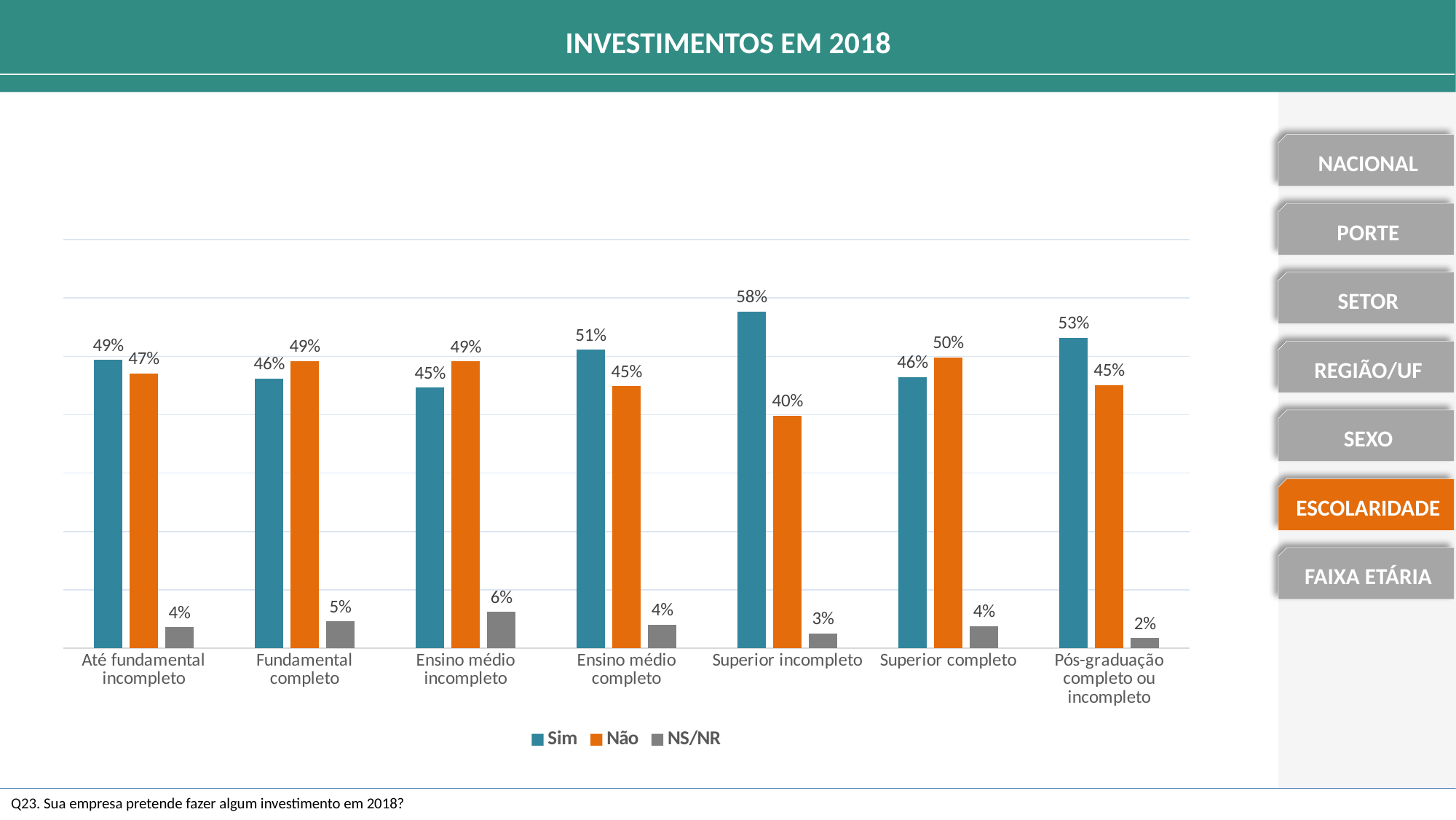
Which category has the highest "Sim" value? Superior incompleto Which series is shown in orange? Não What is the value of "Não" for Ensino médio completo? 45% What is the title of the slide? INVESTIMENTOS EM 2018 Which category has the lowest "NS/NR" value? Pós-graduação completo ou incompleto How many education categories are shown on the x axis? 7 Which is larger for Superior completo, "Sim" or "Não"? Não What is the value of "Sim" for Superior incompleto? 58% How many series does the legend list? 3 What is the value of "NS/NR" for Ensino médio incompleto? 6% What kind of chart is shown on the slide? Bar chart What is the difference between the "Sim" and "Não" values for Superior incompleto? 18%